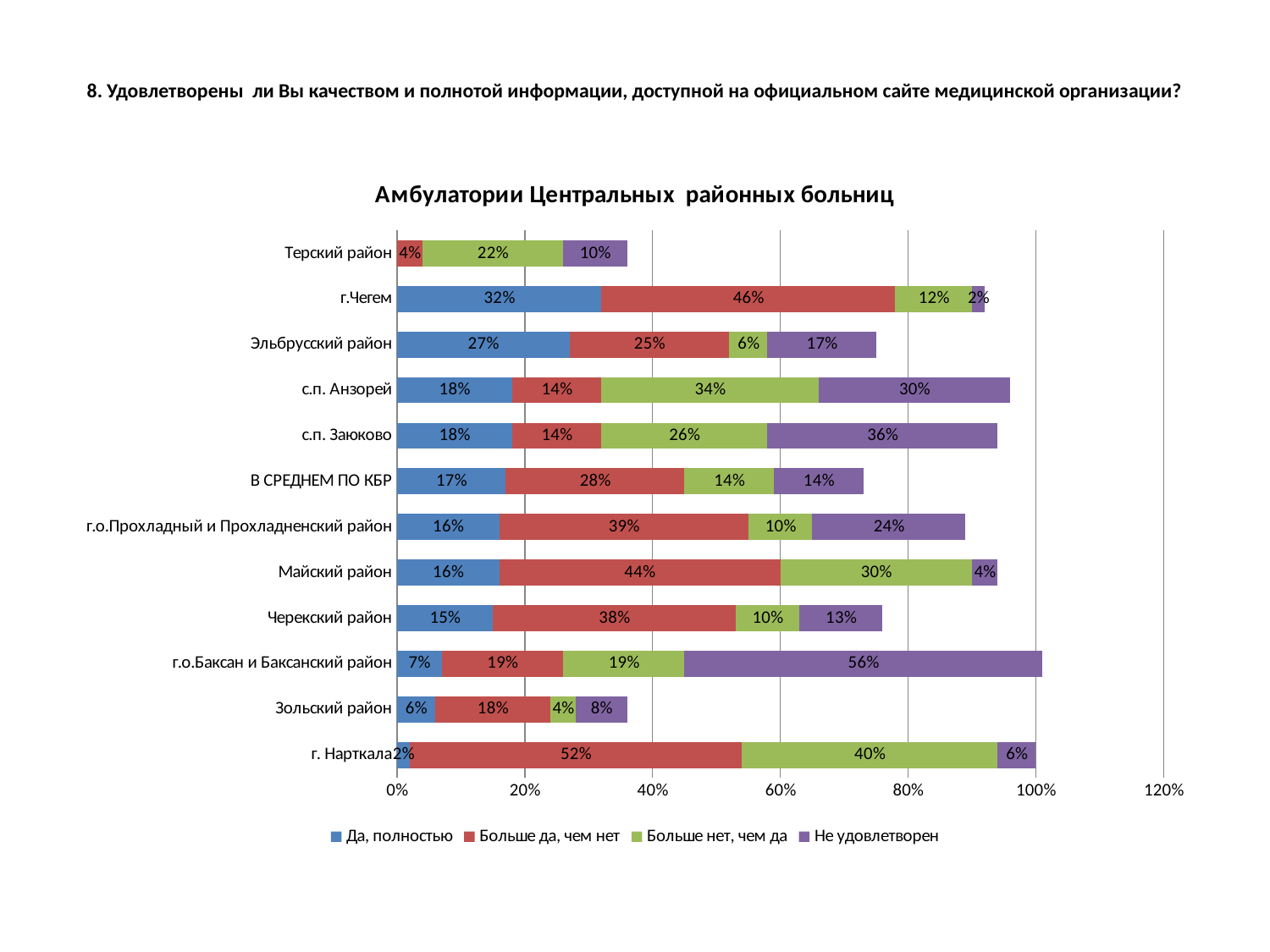
Which category has the highest value for "Да, полностью"? г.Чегем What is the value of "Больше нет, чем да" for с.п. Анзорей? 34% Which category has the highest value for "Не удовлетворен"? г.о.Баксан и Баксанский район What is the difference between the "Больше да, чем нет" values for Майский район and Черекский район? 6% What is the value of "Да, полностью" for г.Чегем? 32% How many series does the legend list? 4 What kind of chart is shown on the slide? stacked bar chart What is the total of the stacked bar for В СРЕДНЕМ ПО КБР? 73% What is the value of "Больше да, чем нет" for г. Нарткала? 52% How many categories are shown on the chart? 12 Which is larger: the "Не удовлетворен" value for с.п. Заюково or for с.п. Анзорей? с.п. Заюково What is the value of "Не удовлетворен" for г.о.Баксан и Баксанский район? 56%